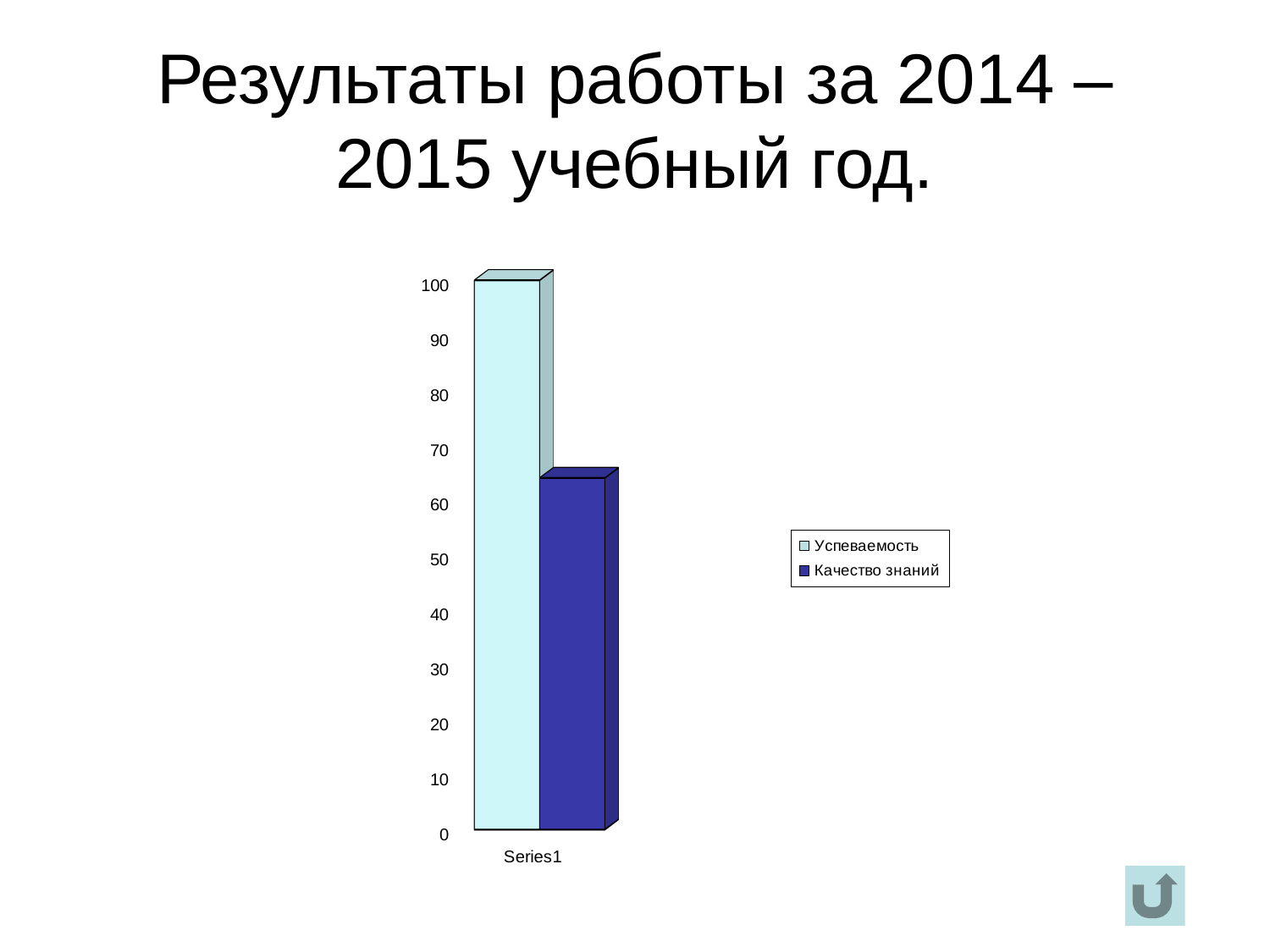
Which series has the lowest value? Качество знаний Which series has the highest value? Успеваемость Which series is shown in dark blue in the legend? Качество знаний What kind of chart is shown on the slide? bar chart How many series does the legend list? 2 Is the value for Качество знаний greater or less than 60? greater What is the label of the category on the x axis? Series1 Is the value for Качество знаний greater or less than 70? less Is the value for Успеваемость greater or less than 90? greater Which series has the higher value: Успеваемость or Качество знаний? Успеваемость How many categories are shown on the x axis? 1